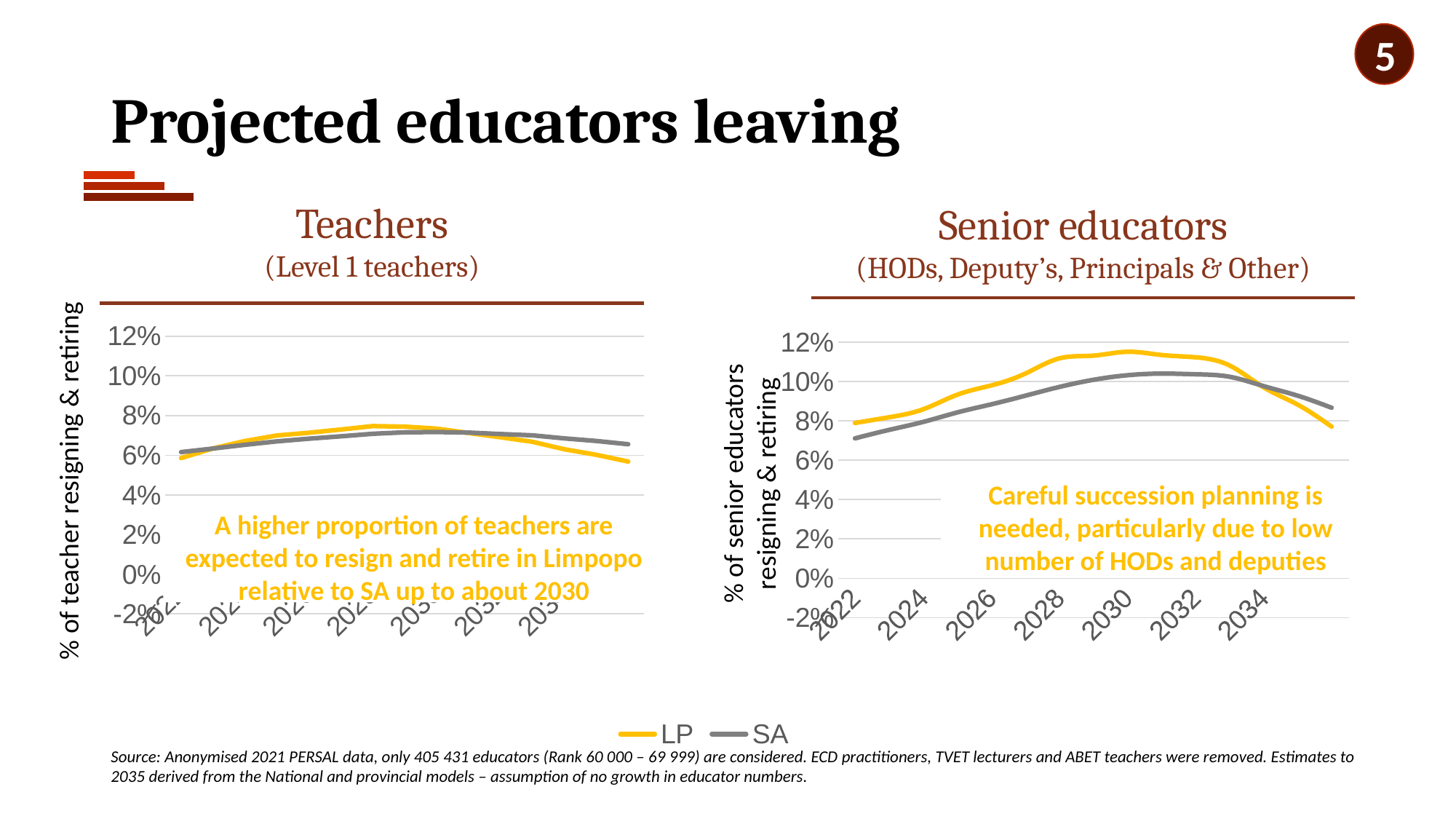
In the Senior educators chart, which series is higher in 2030, LP or SA? LP How many series does the legend list? 2 In the Senior educators chart, is the SA value in 2022 greater or less than 8%? less What kind of chart is the Teachers chart? line chart In the Teachers chart, is the LP value at the start of the series (2022) greater or less than 8%? less In the Senior educators chart, which series is higher at the final point of the series? SA In the Senior educators chart, is the LP value in 2028 greater or less than 10%? greater What are the two series named in the legend? LP and SA In the Senior educators chart, which series reaches the highest value on the chart? LP In the Senior educators chart, does the LP line rise or fall between 2022 and 2030? rise